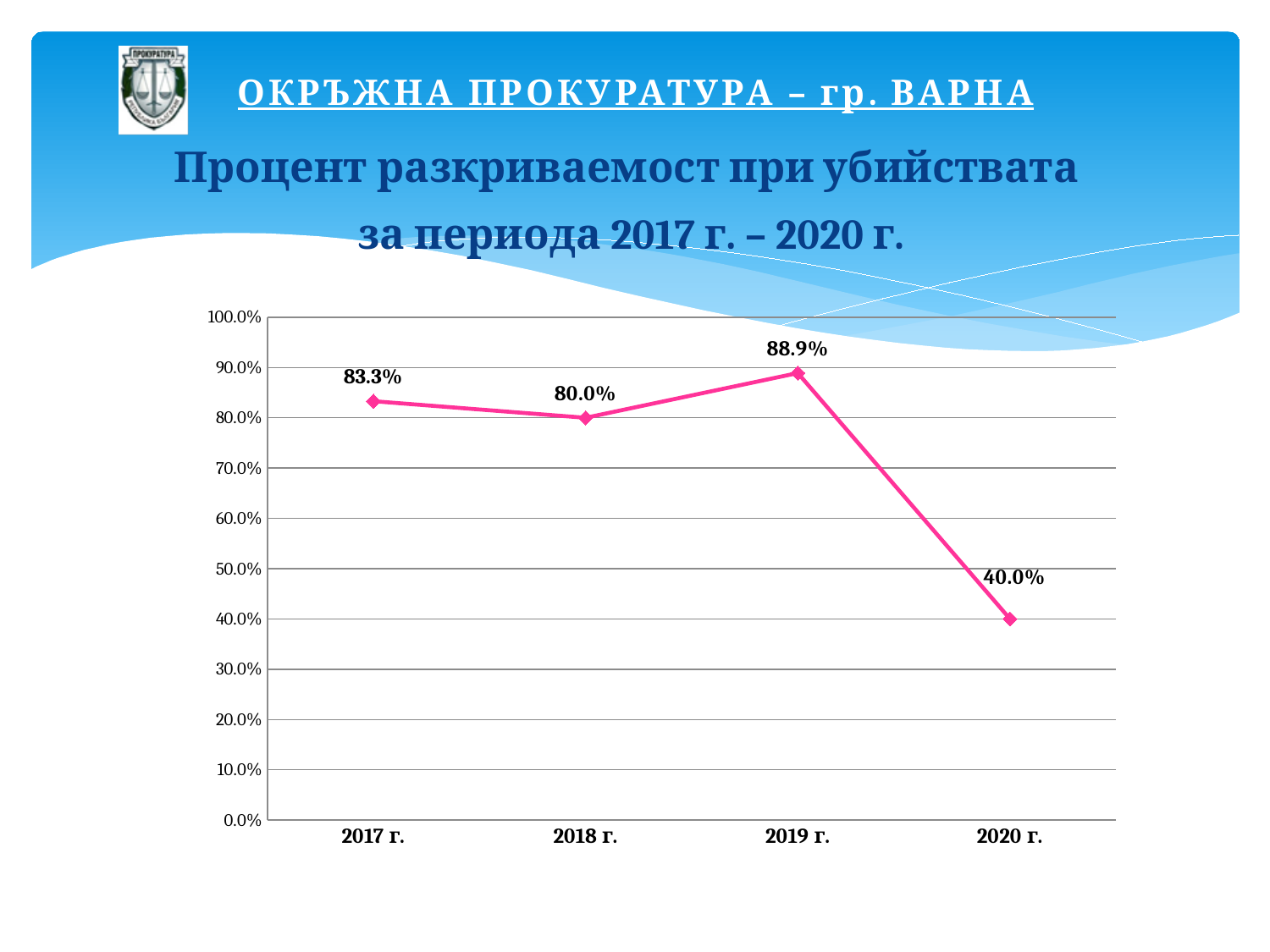
What kind of chart is shown on the slide? line chart What is the value for 2018 г.? 80.0% What is the value for 2017 г.? 83.3% Which year has the lowest value? 2020 г. What is the value for 2019 г.? 88.9% What is the difference between the values for 2019 г. and 2020 г.? 48.9% What is the difference between the values for 2017 г. and 2018 г.? 3.3% What is the value for 2020 г.? 40.0% Does the value rise or fall from 2019 г. to 2020 г.? fall How many years are plotted on the chart? 4 Which is larger, the value for 2017 г. or the value for 2018 г.? 2017 г. Which year has the highest value? 2019 г.